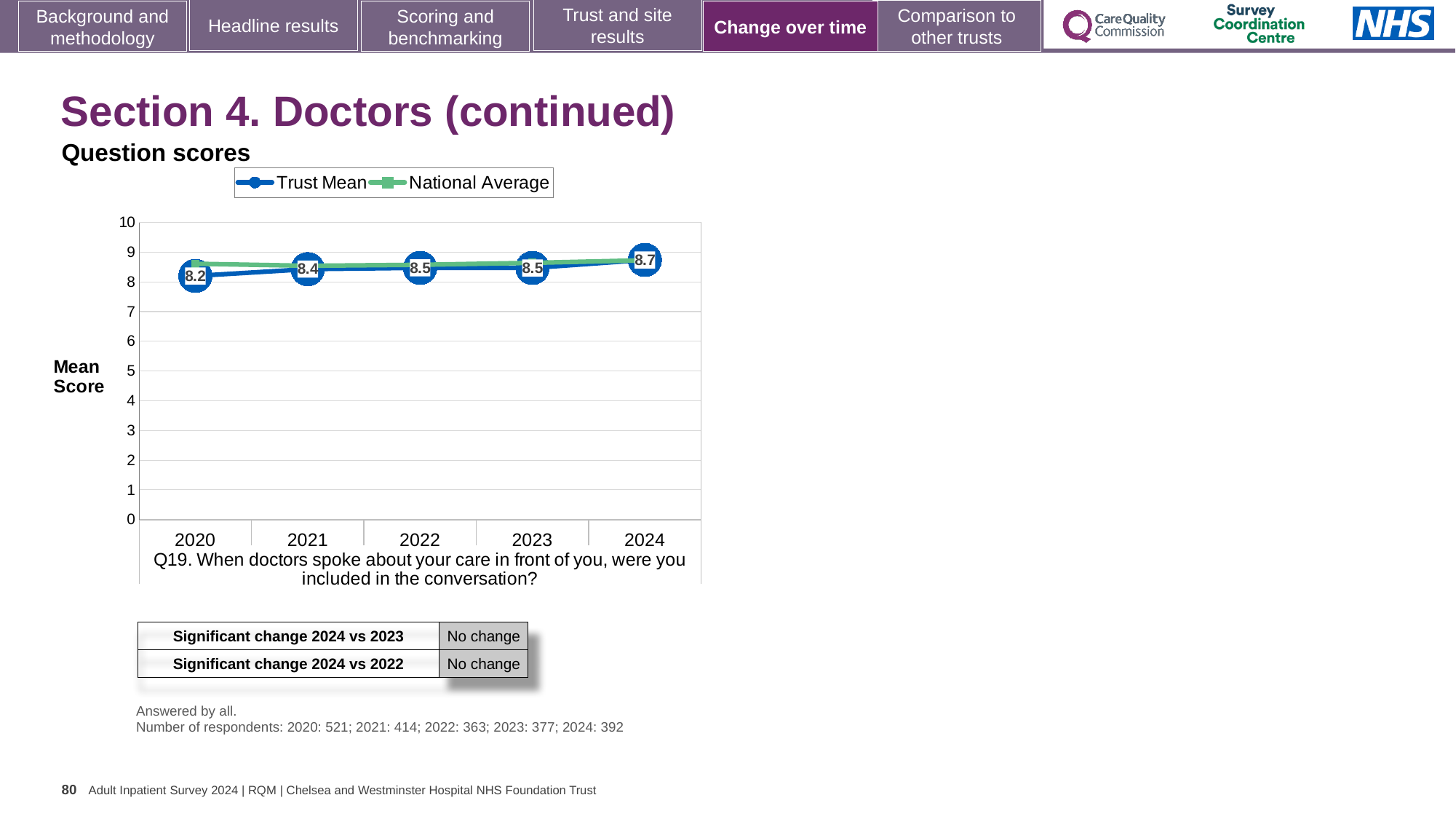
How many years are plotted on the x axis? 5 In which year is the Trust Mean score lowest? 2020 What is the difference between the Trust Mean score in 2024 and in 2020? 0.5 What is the Trust Mean score for 2024? 8.7 How many series does the legend list? 2 In which year is the Trust Mean score highest? 2024 What is the Trust Mean score for 2020? 8.2 What is the Trust Mean score for 2022? 8.5 Is the National Average value for 2020 greater or less than 8? greater Does the Trust Mean score rise or fall from 2020 to 2024? rise Which is larger, the Trust Mean score for 2021 or for 2024? 2024 What kind of chart is shown on the slide? line chart